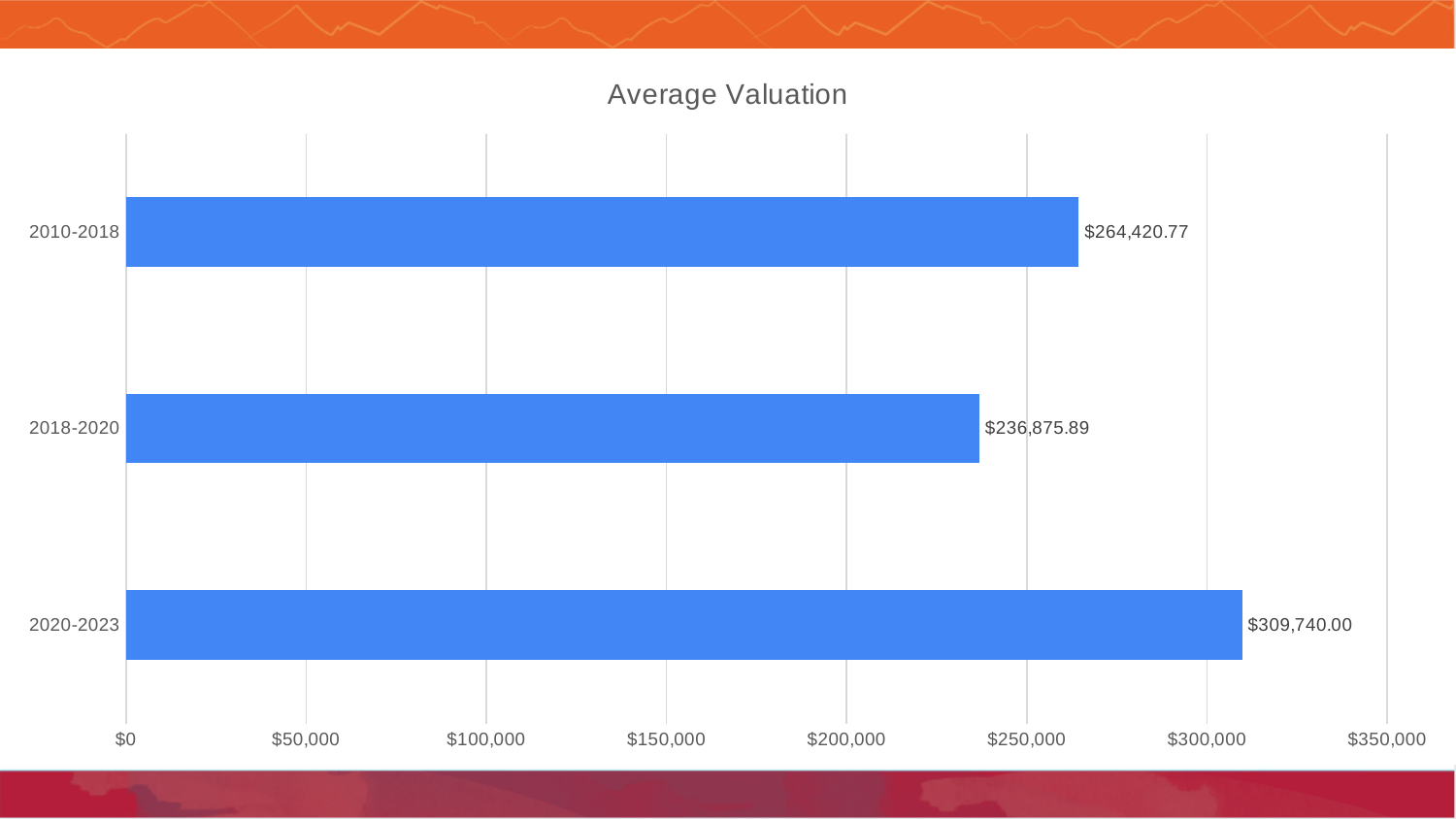
What is the average valuation for 2018-2020? $236,875.89 Which period has the lowest average valuation? 2018-2020 What is the difference between the average valuation for 2010-2018 and 2018-2020? $27,544.88 Is the average valuation for 2020-2023 greater or less than $300,000? greater Which period has the highest average valuation? 2020-2023 What is the title of the chart? Average Valuation How many periods are shown in the chart? 3 What type of chart is shown on the slide? bar chart What is the average valuation for 2010-2018? $264,420.77 What is the difference between the average valuation for 2020-2023 and 2010-2018? $45,319.23 Which period has a larger average valuation, 2010-2018 or 2018-2020? 2010-2018 What is the average valuation for 2020-2023? $309,740.00